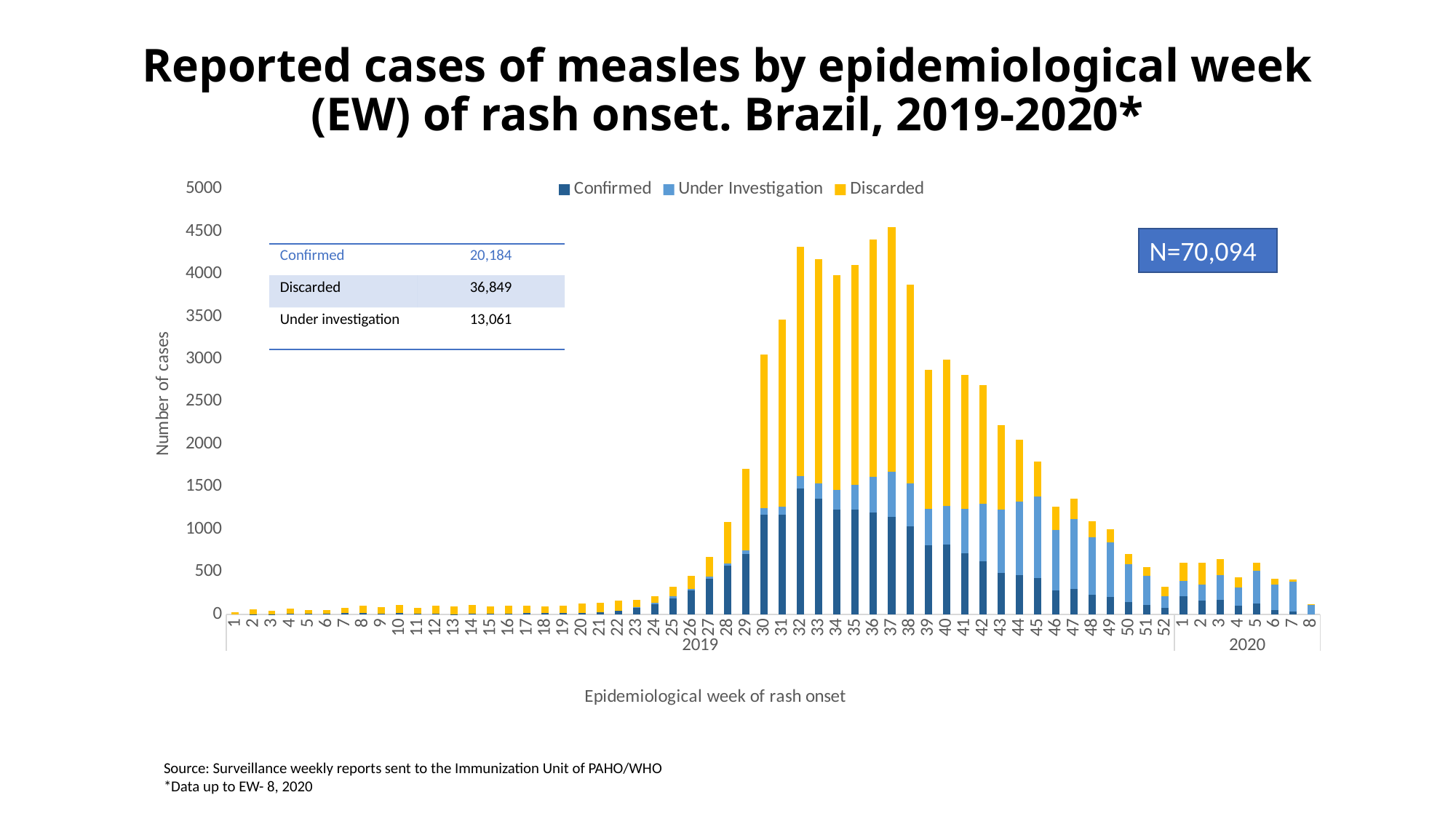
How many series does the legend list? 3 According to the table on the slide, how many cases were discarded? 36,849 Which epidemiological week has the tallest stacked bar? Week 37 of 2019 Do the total cases rise or fall from week 37 to week 52 of 2019? fall What are the three series named in the legend? Confirmed, Under Investigation, Discarded Is the total number of cases for week 8 of 2020 greater or less than 500? less What is the total N shown on the slide? N=70,094 Is the total number of cases for week 29 of 2019 greater or less than 1500? greater Is the total number of cases for week 37 of 2019 greater or less than 4000? greater According to the table on the slide, how many cases were confirmed? 20,184 What kind of chart is shown on the slide? Stacked bar chart What is the difference between the discarded and confirmed totals shown in the table? 16,665